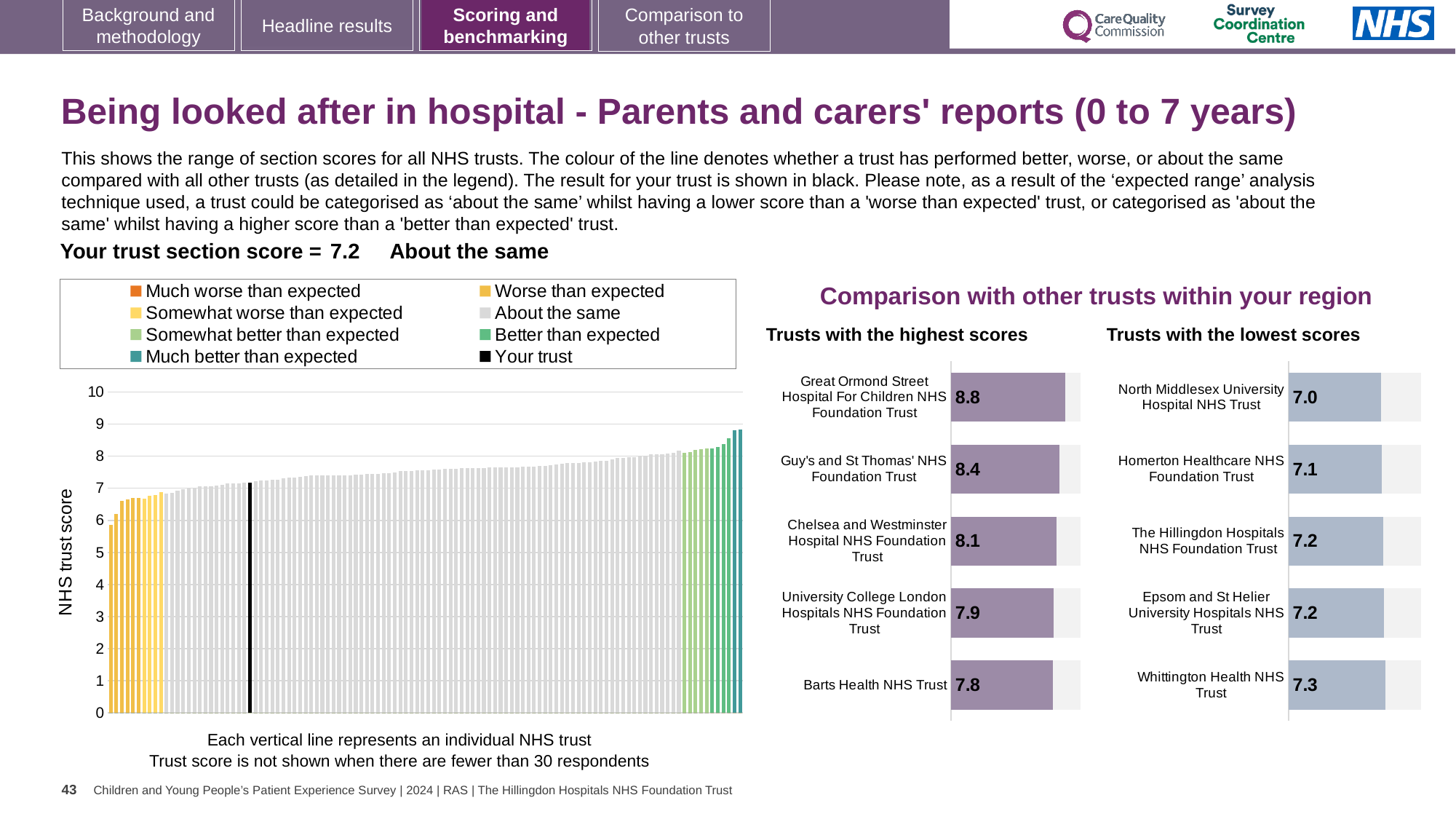
In the 'Trusts with the highest scores' chart, what is the difference between the scores of Great Ormond Street Hospital For Children NHS Foundation Trust and Barts Health NHS Trust? 1.0 How many trusts are shown in the 'Trusts with the lowest scores' chart? 5 In the large chart on the left showing all NHS trusts, do the bar values rise or fall from left to right? rise How many entries does the legend of the large chart on the left list? 8 In the 'Trusts with the lowest scores' chart, what is the score for Whittington Health NHS Trust? 7.3 In the 'Trusts with the highest scores' chart, what is the score for Great Ormond Street Hospital For Children NHS Foundation Trust? 8.8 In the 'Trusts with the highest scores' chart, what is the score for Barts Health NHS Trust? 7.8 In the 'Trusts with the highest scores' chart, which has the larger score: Guy's and St Thomas' NHS Foundation Trust or Chelsea and Westminster Hospital NHS Foundation Trust? Guy's and St Thomas' NHS Foundation Trust In the large chart on the left showing all NHS trusts, is the value for the black bar (Your trust) greater or less than 5? greater In the 'Trusts with the lowest scores' chart, what is the score for North Middlesex University Hospital NHS Trust? 7.0 In the 'Trusts with the highest scores' chart, which trust has the highest score? Great Ormond Street Hospital For Children NHS Foundation Trust In the 'Trusts with the lowest scores' chart, which trust has the lowest score? North Middlesex University Hospital NHS Trust